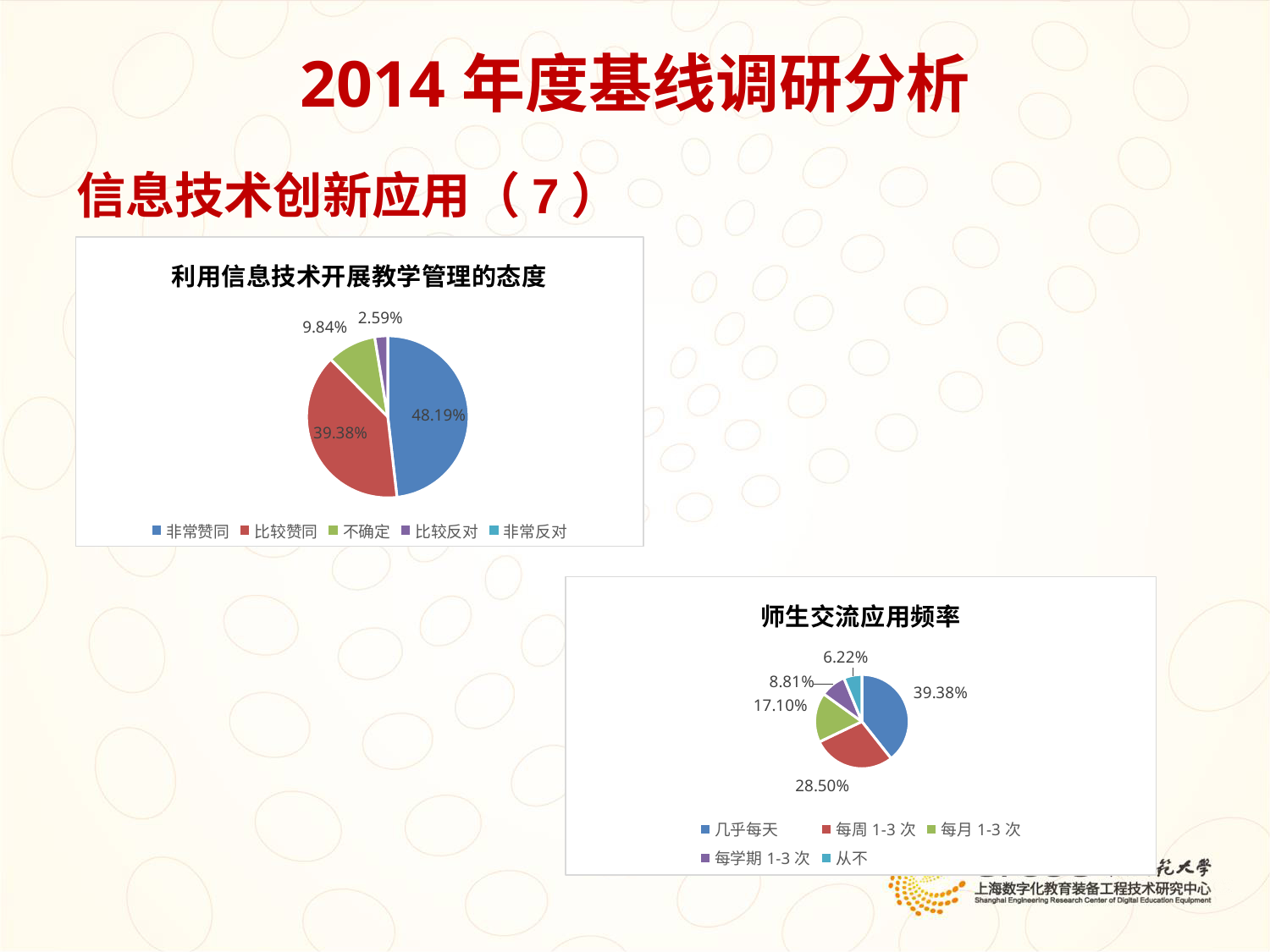
In the chart titled 师生交流应用频率, which category has the smallest slice? 从不 In the chart titled 师生交流应用频率, what colour is the 几乎每天 slice? blue In the chart titled 利用信息技术开展教学管理的态度, how many entries does the legend list? 5 In the chart titled 师生交流应用频率, what share does 几乎每天 have? 39.38% In the chart titled 利用信息技术开展教学管理的态度, what share does 比较赞同 have? 39.38% In the chart titled 师生交流应用频率, which is larger, 每周 1-3 次 or 每学期 1-3 次? 每周 1-3 次 In the chart titled 利用信息技术开展教学管理的态度, what is the difference between the 非常赞同 and 比较赞同 shares? 8.81% In the chart titled 师生交流应用频率, what is the difference between the 每周 1-3 次 and 每月 1-3 次 shares? 11.40% In the chart titled 利用信息技术开展教学管理的态度, which category has the largest slice? 非常赞同 What kind of chart is the chart titled 师生交流应用频率? pie chart In the chart titled 师生交流应用频率, what share does 每月 1-3 次 have? 17.10% In the chart titled 利用信息技术开展教学管理的态度, what share does 非常赞同 have? 48.19%